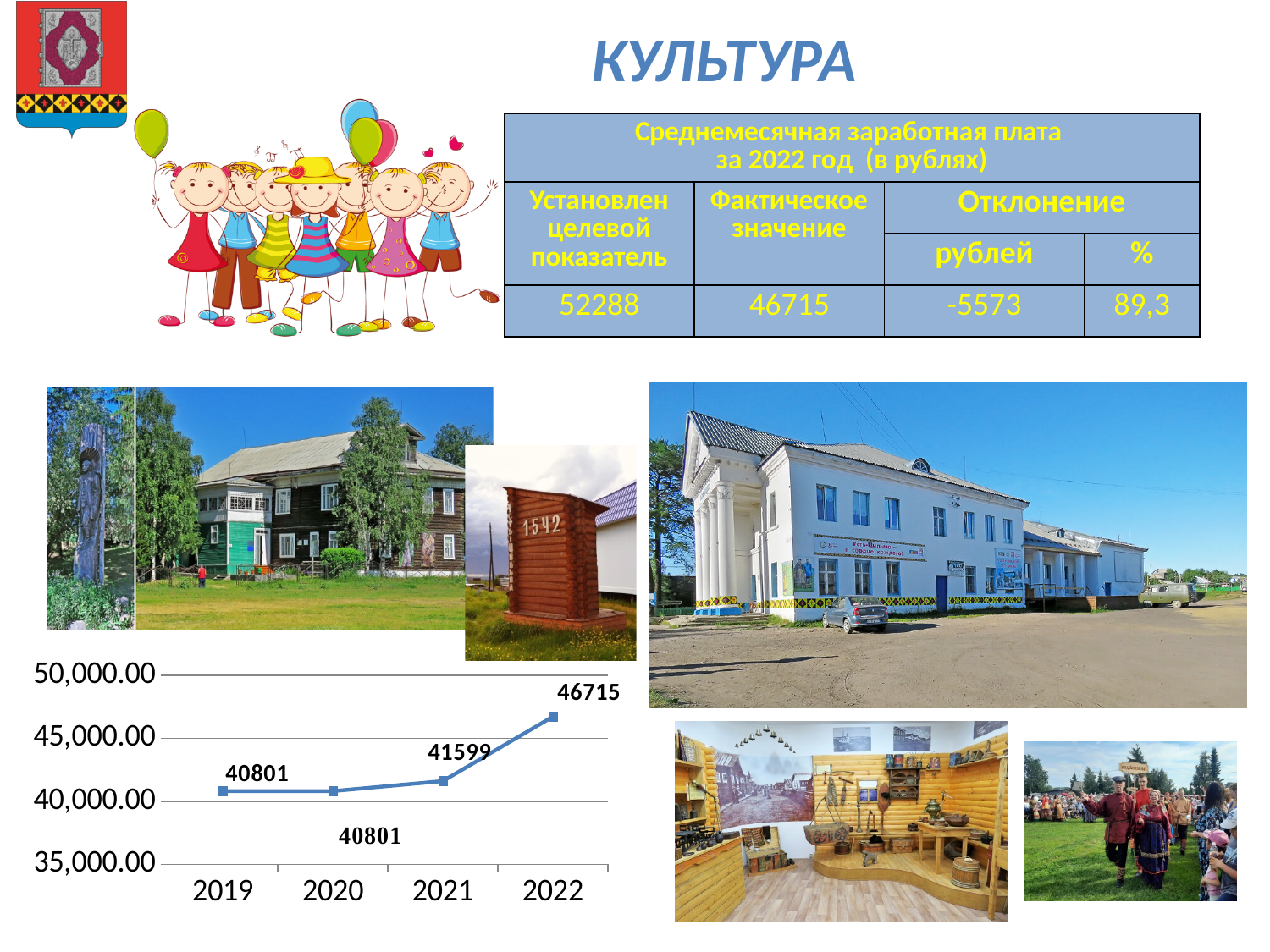
Do the values in the line chart rise or fall from 2019 to 2022? rise In the line chart, what is the difference between the values for 2022 and 2021? 5116 In the line chart, what is the value for 2020? 40801 In the line chart, which year has the highest value? 2022 In the line chart, what is the value for 2022? 46715 In the line chart, is the value for 2022 greater or less than 45,000.00? greater In the line chart, which is larger, the value for 2021 or the value for 2022? 2022 How many years are plotted on the x axis of the line chart? 4 In the line chart, what is the value for 2021? 41599 What kind of chart is shown at the bottom left of the slide? line chart In the line chart, what is the value for 2019? 40801 In the line chart, what is the difference between the values for 2021 and 2019? 798